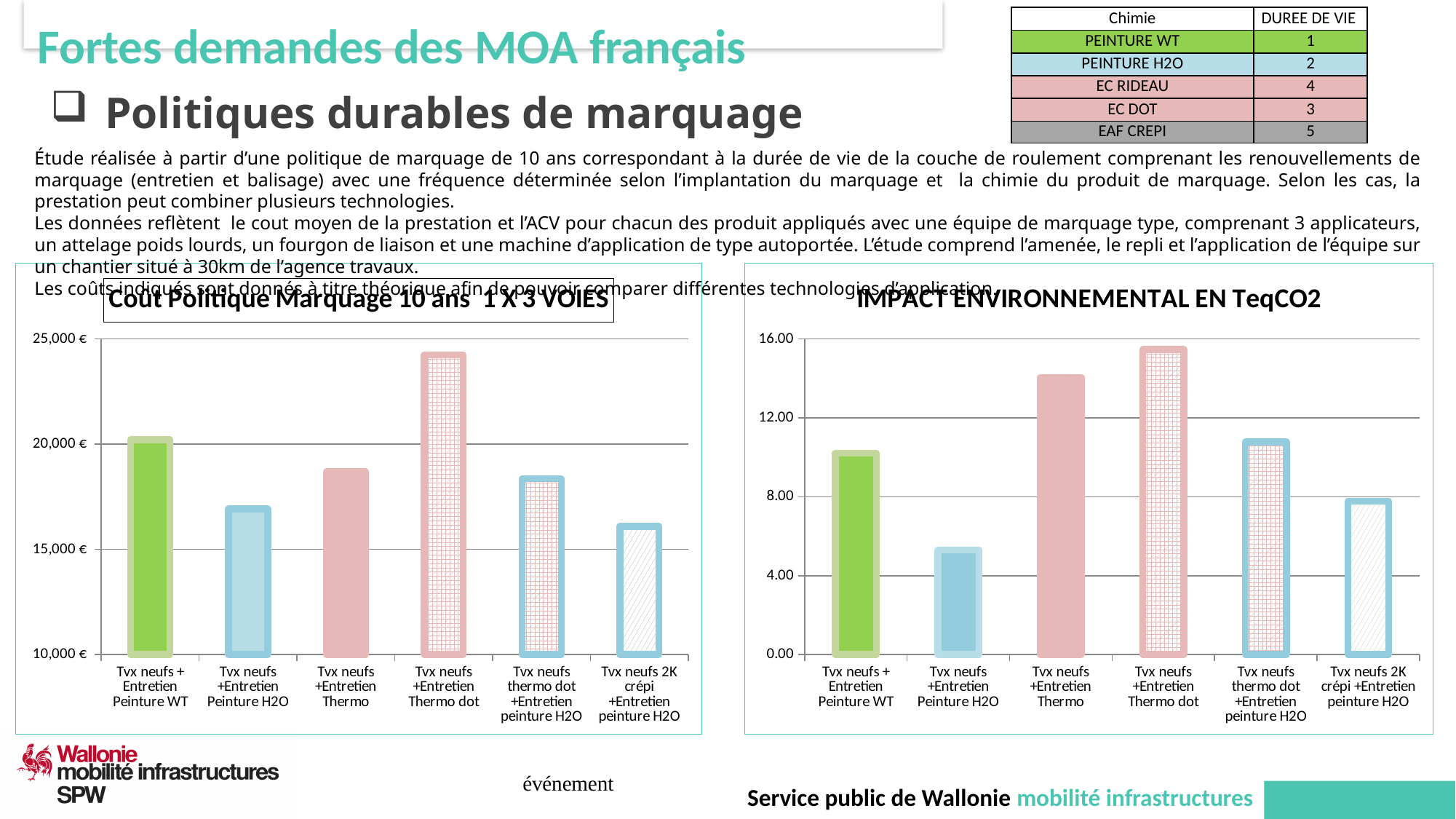
On the left chart 'Cout Politique Marquage 10 ans 1 X 3 VOIES', which category has the lowest cost? Tvx neufs 2K crépi +Entretien peinture H2O On the right chart 'IMPACT ENVIRONNEMENTAL EN TeqCO2', which is larger: 'Tvx neufs + Entretien Peinture WT' or 'Tvx neufs 2K crépi +Entretien peinture H2O'? Tvx neufs + Entretien Peinture WT On the left chart 'Cout Politique Marquage 10 ans 1 X 3 VOIES', which is larger: 'Tvx neufs +Entretien Thermo' or 'Tvx neufs +Entretien Peinture H2O'? Tvx neufs +Entretien Thermo What kind of chart is the left chart titled 'Cout Politique Marquage 10 ans 1 X 3 VOIES'? bar chart On the left chart 'Cout Politique Marquage 10 ans 1 X 3 VOIES', is the value for 'Tvx neufs +Entretien Peinture H2O' greater or less than 20,000 €? less On the right chart 'IMPACT ENVIRONNEMENTAL EN TeqCO2', which category has the lowest value? Tvx neufs +Entretien Peinture H2O On the right chart 'IMPACT ENVIRONNEMENTAL EN TeqCO2', which category has the highest value? Tvx neufs +Entretien Thermo dot What is the title of the right chart? IMPACT ENVIRONNEMENTAL EN TeqCO2 On the left chart 'Cout Politique Marquage 10 ans 1 X 3 VOIES', which category has the highest cost? Tvx neufs +Entretien Thermo dot On the left chart 'Cout Politique Marquage 10 ans 1 X 3 VOIES', is the value for 'Tvx neufs + Entretien Peinture WT' greater or less than 20,000 €? greater On the right chart 'IMPACT ENVIRONNEMENTAL EN TeqCO2', is the value for 'Tvx neufs +Entretien Thermo' greater or less than 12.00? greater How many categories are shown on the left chart 'Cout Politique Marquage 10 ans 1 X 3 VOIES'? 6